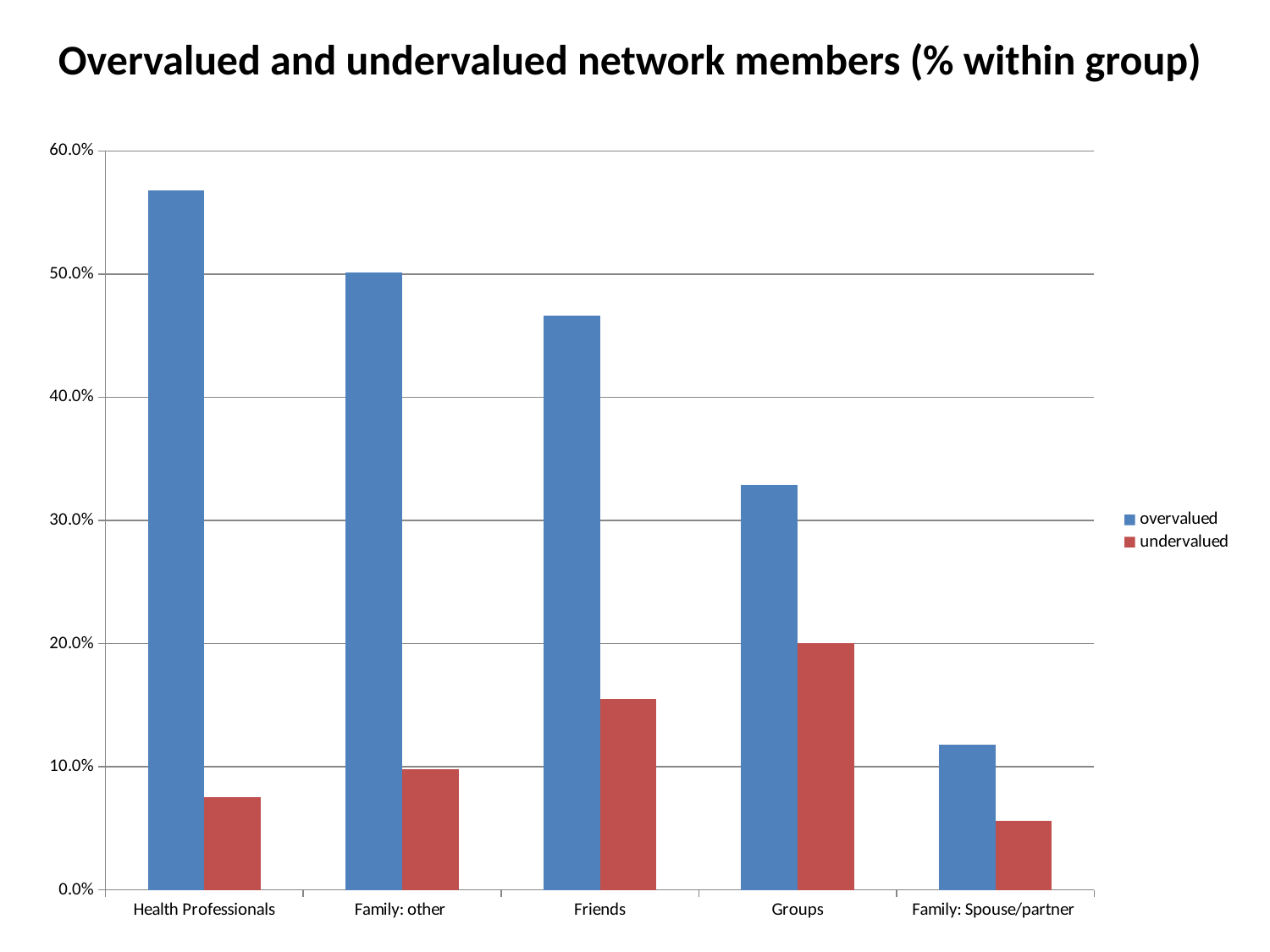
Which is larger: the overvalued value for Groups or the overvalued value for Friends? Friends Which category has the lowest undervalued value? Family: Spouse/partner How many series does the legend list? 2 Which colour represents the undervalued series in the legend? red Is the undervalued value for Health Professionals greater or less than 10.0%? less Do the overvalued values rise or fall moving left to right across the categories? fall What kind of chart is shown on the slide? bar chart Which category has the lowest overvalued value? Family: Spouse/partner Which category has the highest overvalued value? Health Professionals Is the overvalued value for Friends greater or less than 40.0%? greater Which category has the highest undervalued value? Groups How many categories are shown on the x axis? 5